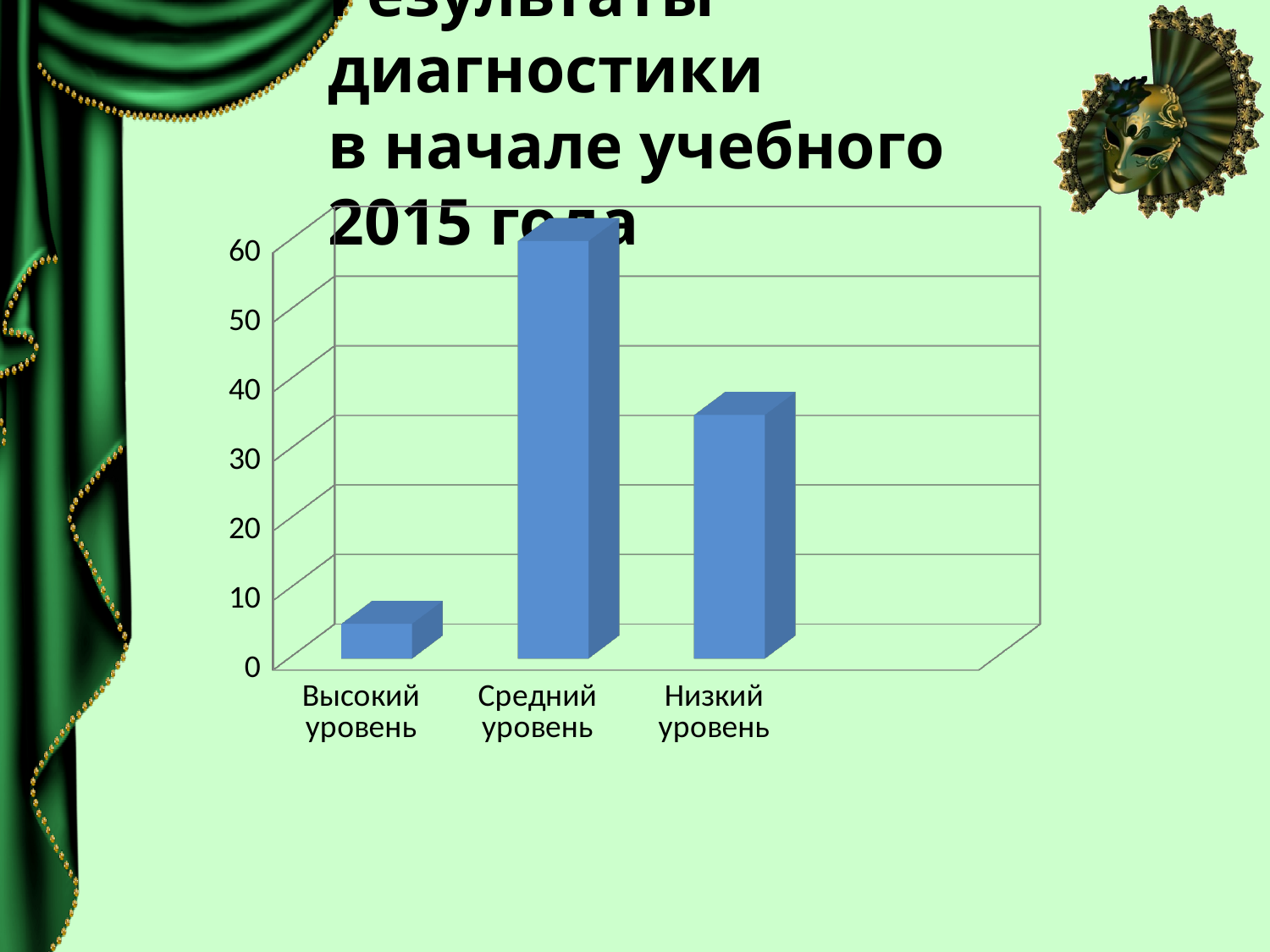
Which category has the highest bar? Средний уровень What is the label of the middle category on the x axis? Средний уровень Is the value for Средний уровень greater or less than 50? greater What kind of chart is shown on the slide? bar chart Is the value for Низкий уровень greater or less than 40? less Which category has the lowest bar? Высокий уровень Is the value for Низкий уровень greater or less than 30? greater Which is larger, the value for Высокий уровень or the value for Низкий уровень? Низкий уровень Which is larger, the value for Средний уровень or the value for Низкий уровень? Средний уровень How many categories are shown on the x axis of the chart? 3 What is the highest tick value shown on the vertical axis of the chart? 60